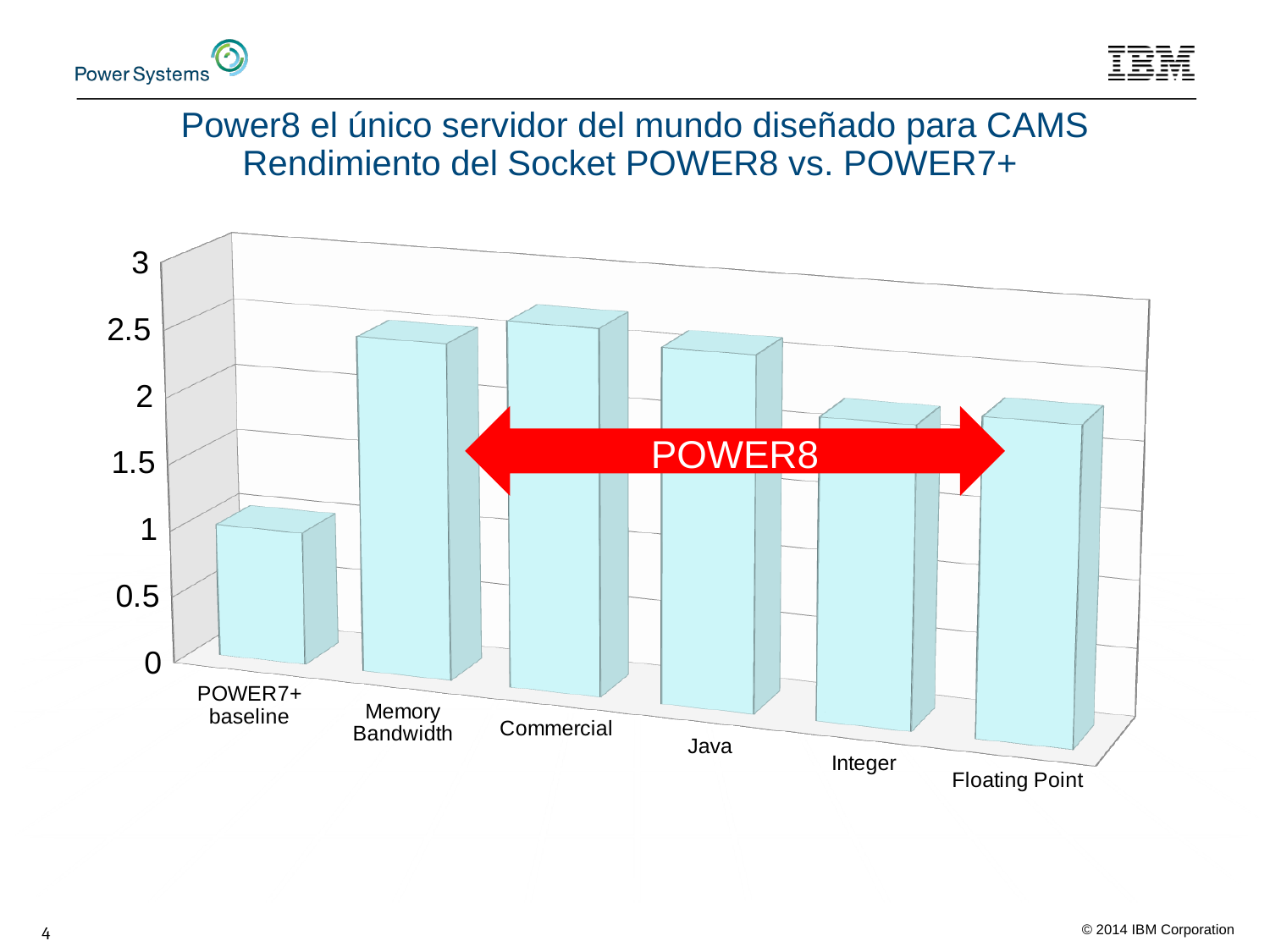
Which is larger, the value for Java or the value for Floating Point? Java Which category has the lowest bar in the chart? POWER7+ baseline How many categories are plotted on the x axis of the chart? 6 Is the value for Java greater or less than 2? greater Which is larger, the value for Memory Bandwidth or the value for Integer? Memory Bandwidth What kind of chart is shown on the slide? bar chart Which category has the highest bar in the chart? Commercial What label is written on the red arrow spanning the bars? POWER8 Is the value for Memory Bandwidth greater or less than 2? greater Is the value for POWER7+ baseline greater or less than 1.5? less What is the highest value shown on the vertical axis of the chart? 3